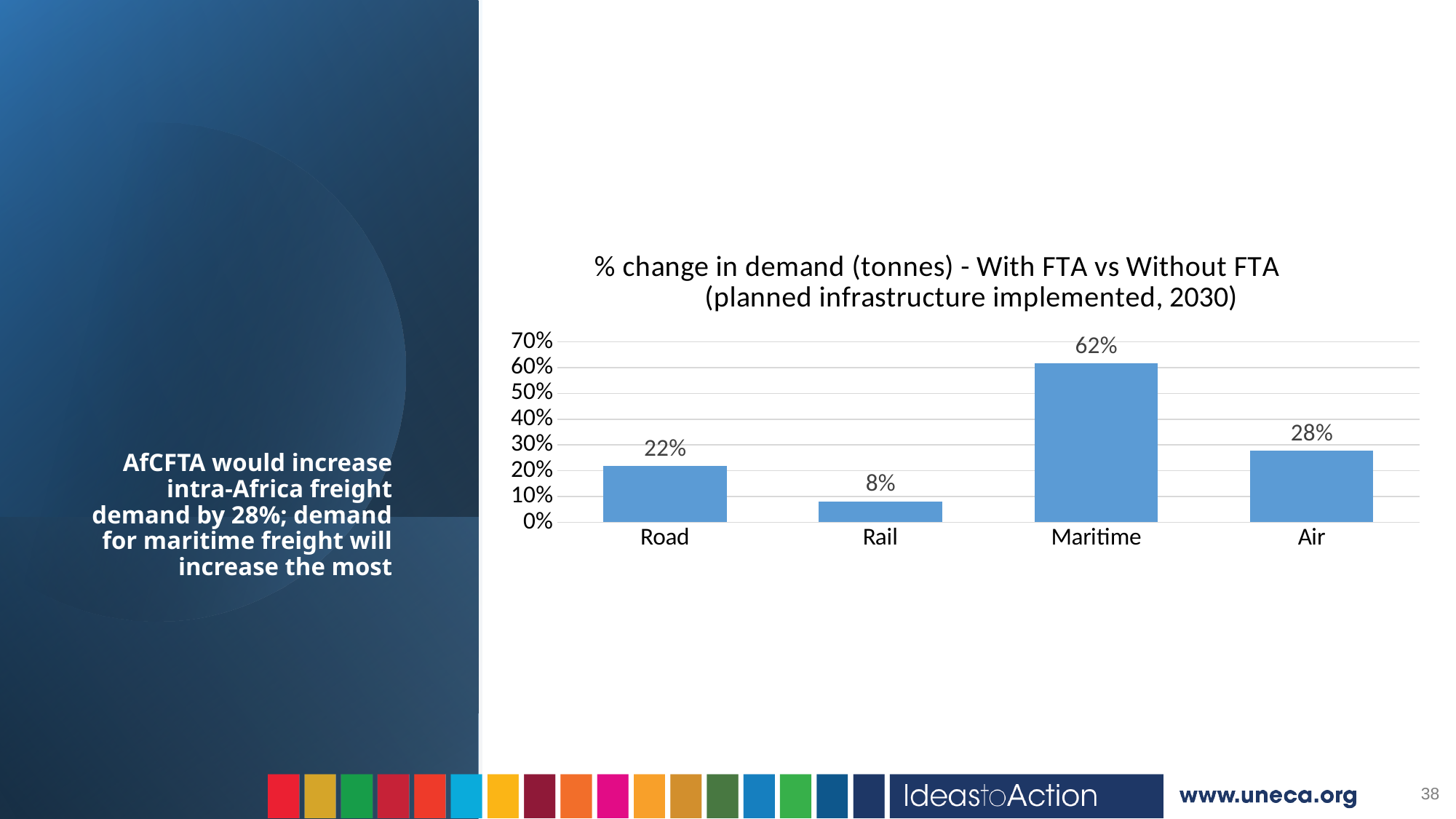
What is the % change in demand for Road? 22% What is the difference between the % change in demand for Maritime and Air? 34% How many transport modes are shown on the x axis? 4 What is the % change in demand for Rail? 8% Which transport mode has the lowest % change in demand? Rail Which has a larger % change in demand, Road or Air? Air What is the title of the chart? % change in demand (tonnes) - With FTA vs Without FTA (planned infrastructure implemented, 2030) What is the % change in demand for Air? 28% What is the % change in demand for Maritime? 62% Which transport mode has the highest % change in demand? Maritime Is the value for Maritime greater or less than 50%? greater What kind of chart is shown on the slide? Bar chart